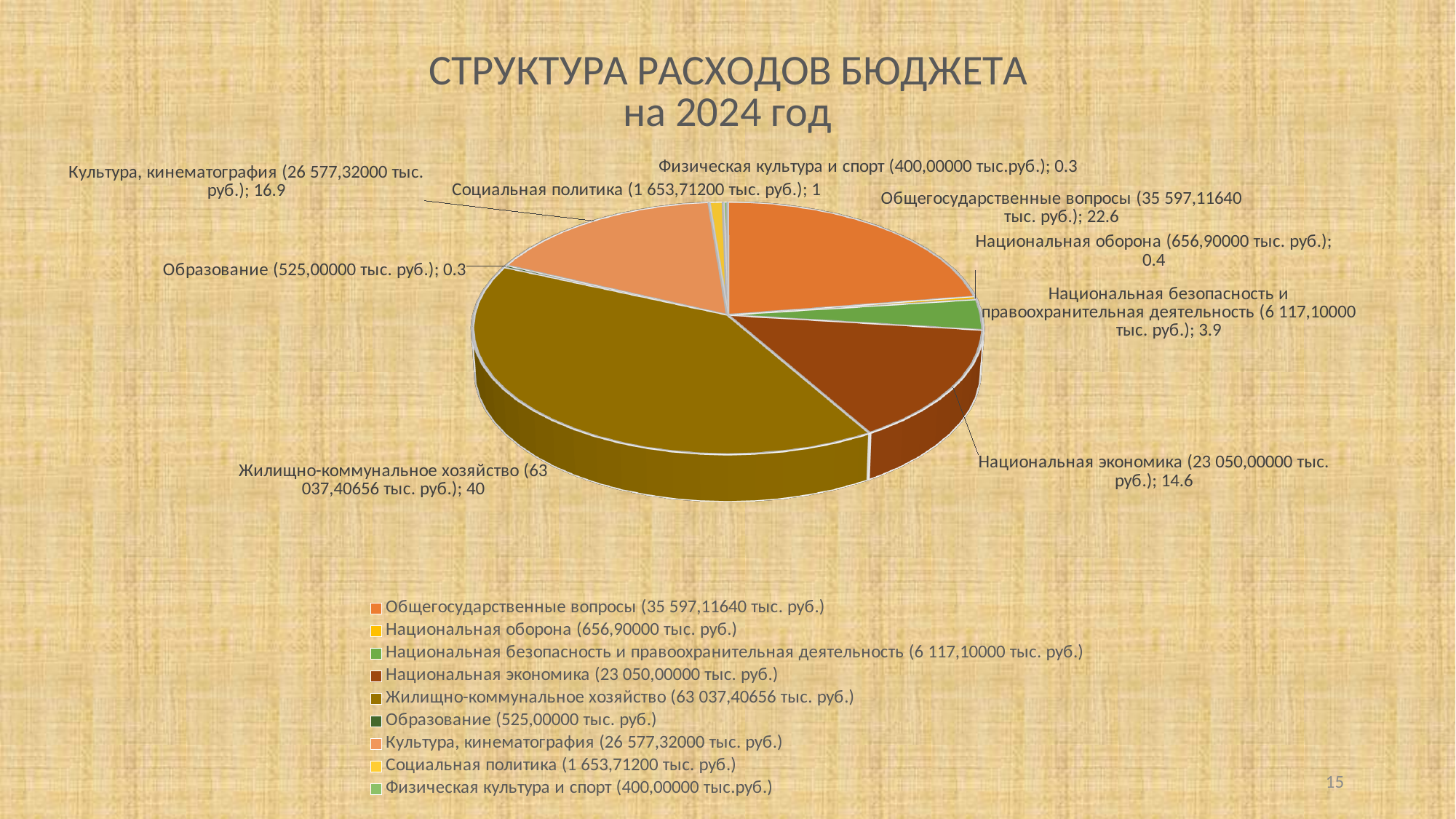
What amount is shown for Культура, кинематография? 26 577,32000 тыс. руб. What is the title of the chart? СТРУКТУРА РАСХОДОВ БЮДЖЕТА на 2024 год What kind of chart is shown on the slide? Pie chart How many categories does the pie chart show? 9 What is the difference in percentage share between Жилищно-коммунальное хозяйство and Общегосударственные вопросы? 17.4 Which category has the smallest amount in the chart? Физическая культура и спорт Which has a larger share: Национальная экономика or Культура, кинематография? Культура, кинематография What percentage share is shown for Жилищно-коммунальное хозяйство? 40 What percentage share is shown for Национальная безопасность и правоохранительная деятельность? 3.9 What amount is shown for Национальная экономика? 23 050,00000 тыс. руб. What percentage share is shown for Общегосударственные вопросы? 22.6 Which category has the largest share of the pie? Жилищно-коммунальное хозяйство